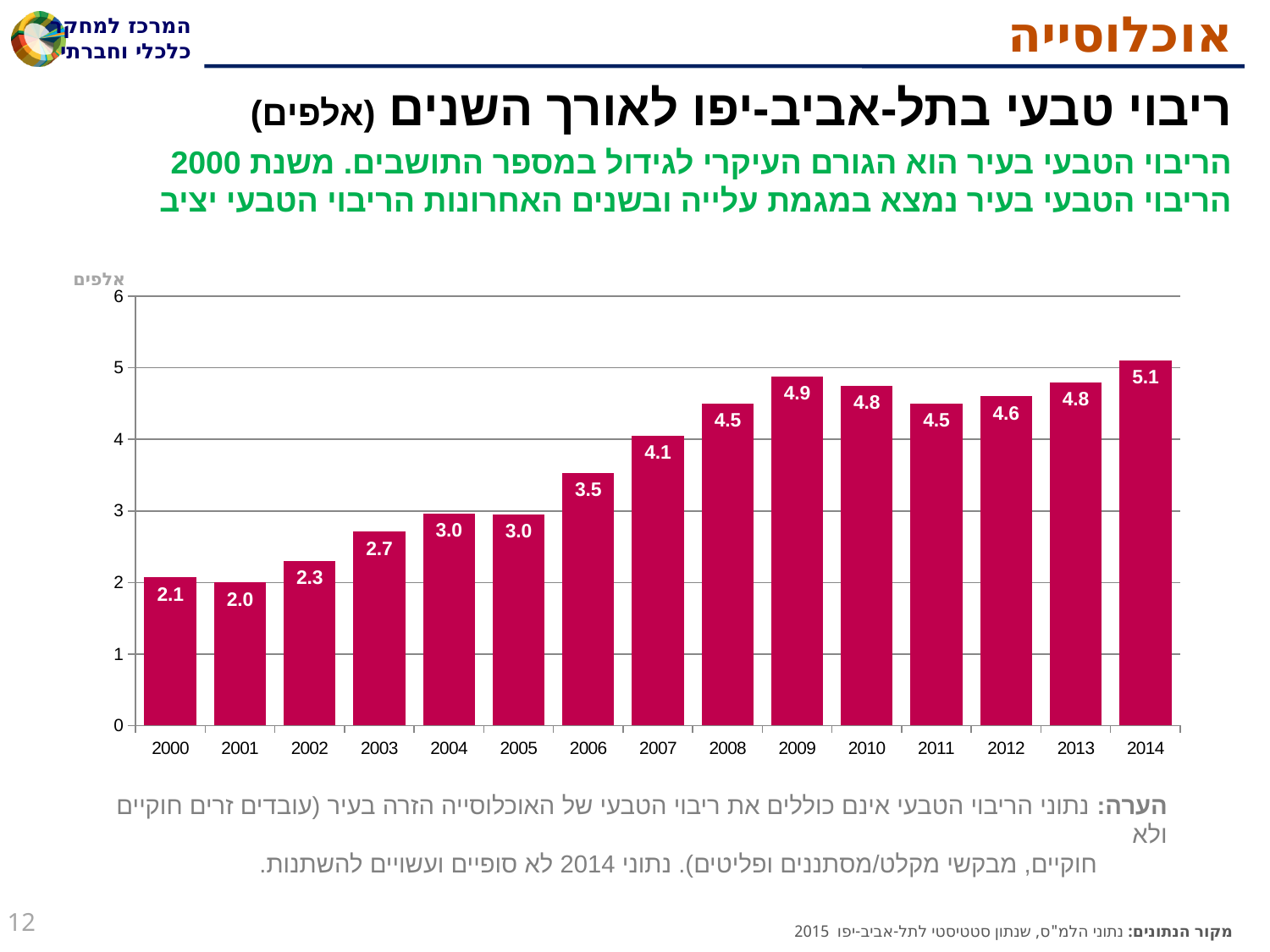
What is the difference between the values for 2009 and 2006? 1.4 Which is larger, the value for 2007 or the value for 2012? 2012 What kind of chart is shown on the slide? bar chart Which year has the highest value? 2014 What is the difference between the values for 2014 and 2000? 3.0 What is the value for 2003? 2.7 Do the values generally rise or fall from 2000 to 2014? rise How many years are shown on the x axis? 15 What is the value for 2009? 4.9 What is the value for 2014? 5.1 Which year has the lowest value? 2001 Is the value for 2008 greater or less than 4? greater